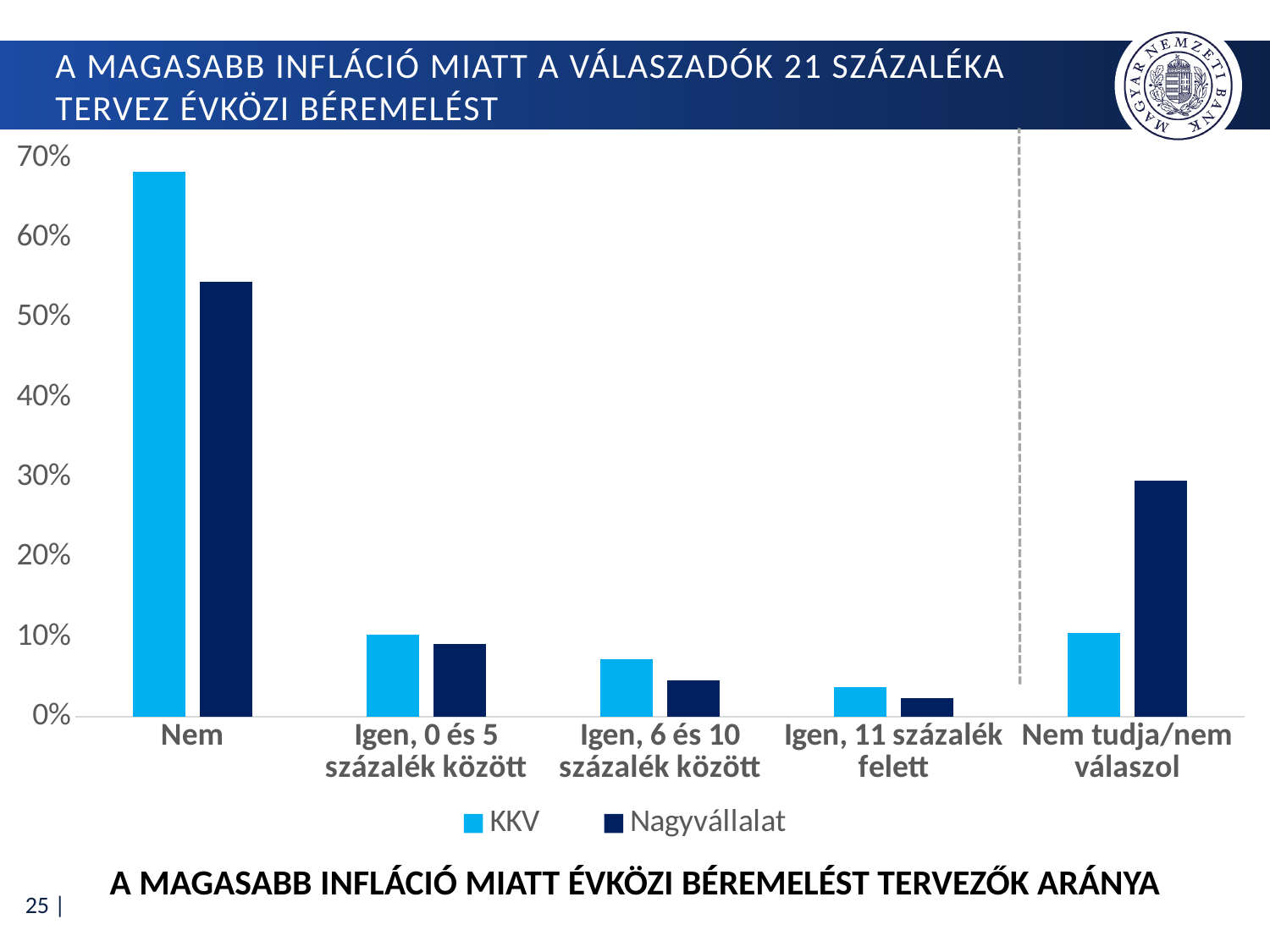
How many series does the legend list? 2 Is the KKV value for Nem greater or less than 60%? greater Which category has the highest Nagyvállalat value? Nem Which category has the lowest KKV value? Igen, 11 százalék felett How many categories are shown on the x axis? 5 Is the Nagyvállalat value for Nem greater or less than 60%? less Which series is shown in light blue in the legend? KKV Which category has the highest KKV value? Nem What kind of chart is shown on the slide? bar chart Is the Nagyvállalat value for Nem tudja/nem válaszol greater or less than 20%? greater Which category has the lowest Nagyvállalat value? Igen, 11 százalék felett For Nem tudja/nem válaszol, which series has the larger value, KKV or Nagyvállalat? Nagyvállalat